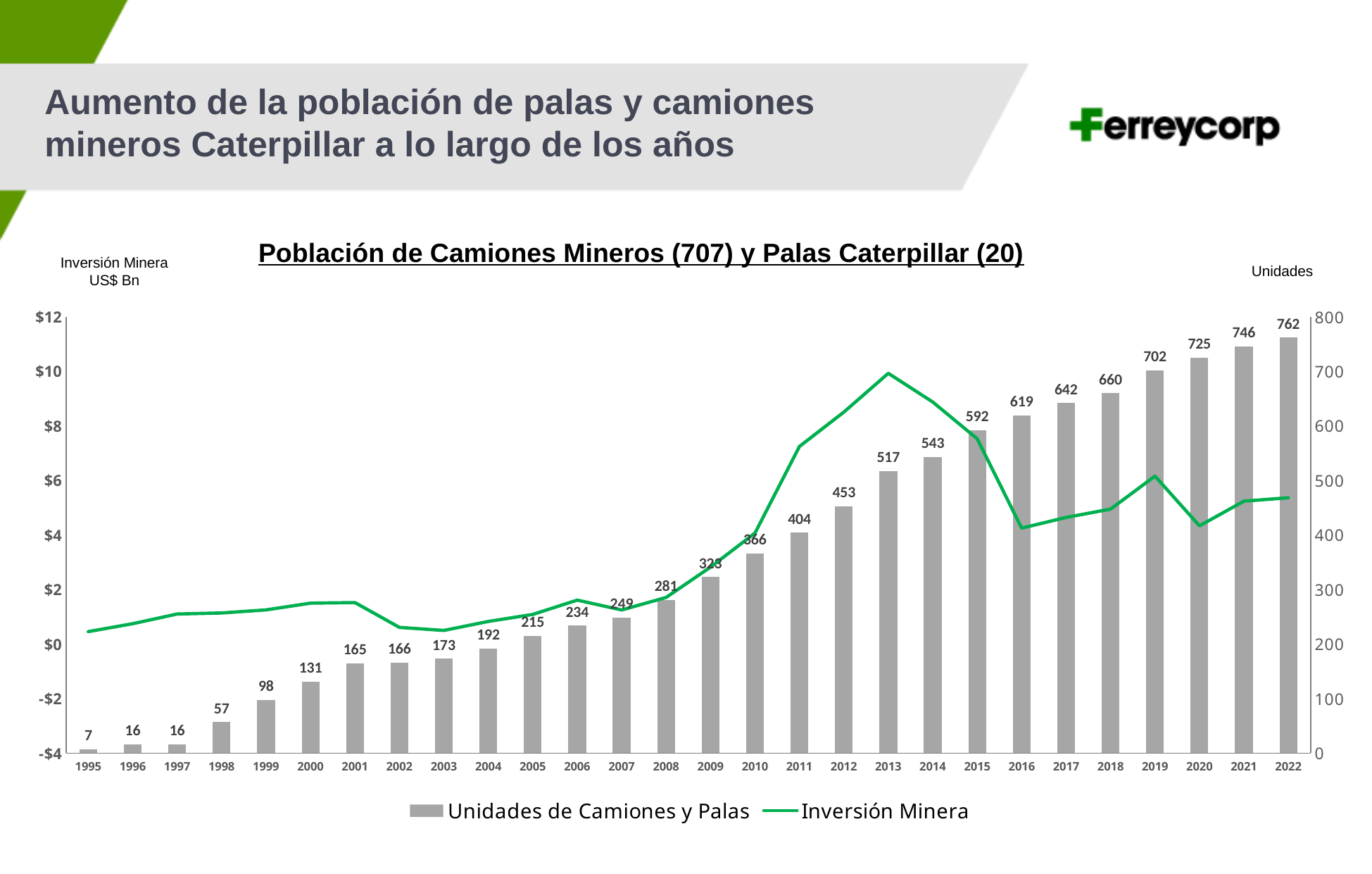
Which year has the lowest value of Unidades de Camiones y Palas? 1995 How many years are shown on the x axis of the chart? 28 What is the difference between the Unidades de Camiones y Palas values for 2013 and 2012? 64 Which year has the highest value of Unidades de Camiones y Palas? 2022 Is the Inversión Minera value for 2013 greater or less than $8? greater What is the difference between the Unidades de Camiones y Palas values for 2022 and 2021? 16 Which year has a larger value of Unidades de Camiones y Palas, 2005 or 2006? 2006 What is the value of Unidades de Camiones y Palas for 2010? 366 What is the value of Unidades de Camiones y Palas for 2000? 131 How many series does the legend list? 2 Is the Inversión Minera value for 2003 greater or less than $2? less What is the value of Unidades de Camiones y Palas for 2015? 592